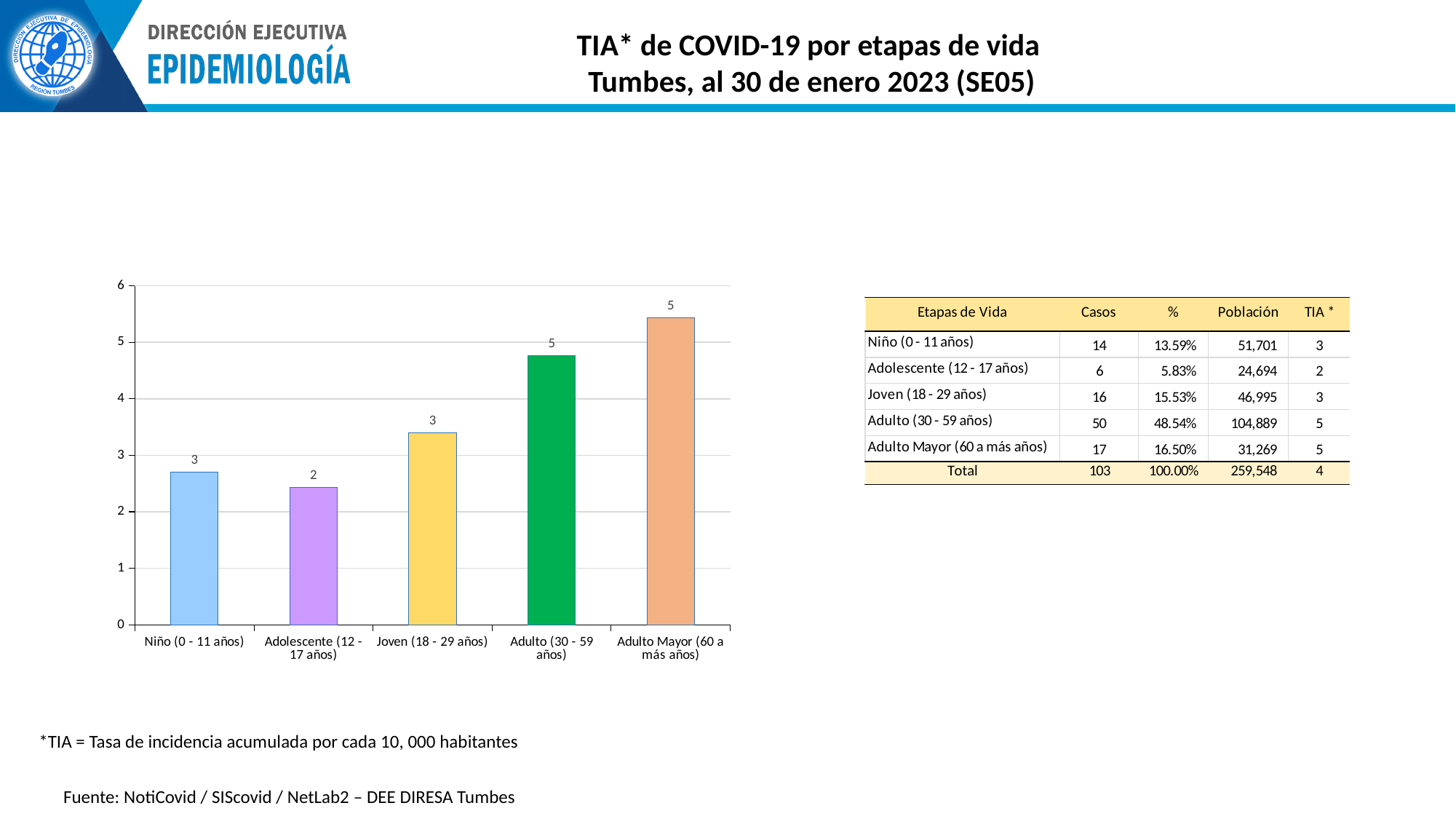
Is the bar for Adulto (30 - 59 años) greater or less than 4? greater What kind of chart is used to show the TIA by life stage? Bar chart What is the TIA value shown for Adolescente (12 - 17 años)? 2 Which bar is taller: Joven (18 - 29 años) or Adulto (30 - 59 años)? Adulto (30 - 59 años) Is the bar for Adolescente (12 - 17 años) greater or less than 3? less What is the TIA value shown for Niño (0 - 11 años)? 3 What is the TIA value shown for Adulto (30 - 59 años)? 5 What is the TIA value shown for Joven (18 - 29 años)? 3 Which life stage has the lowest bar in the chart? Adolescente (12 - 17 años) What colour is the bar for Adulto (30 - 59 años)? Green How many life-stage categories are plotted in the chart? 5 Which life stage has the tallest bar in the chart? Adulto Mayor (60 a más años)